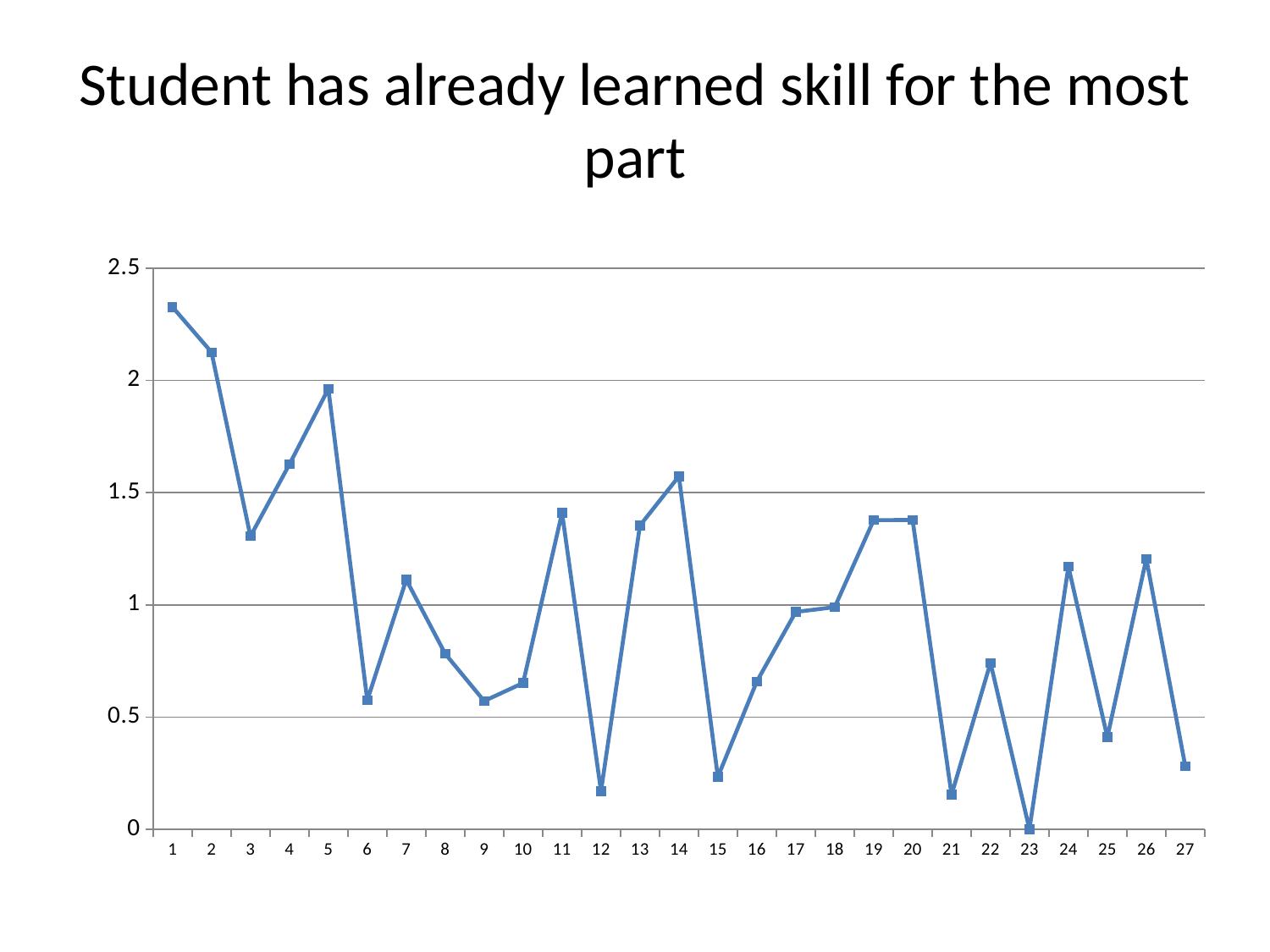
Is the value for category 19 greater or less than 1.5? less What kind of chart is shown on the slide? line chart Is the value for category 26 greater or less than 1? greater Which x-axis category has the lowest value? 23 Is the value for category 1 greater or less than 2? greater Overall, do the values tend to rise or fall from category 1 to category 27? fall Which x-axis category has the highest value? 1 How many points are plotted along the x axis? 27 What is the title of the chart? Student has already learned skill for the most part Which has the larger value, category 12 or category 13? 13